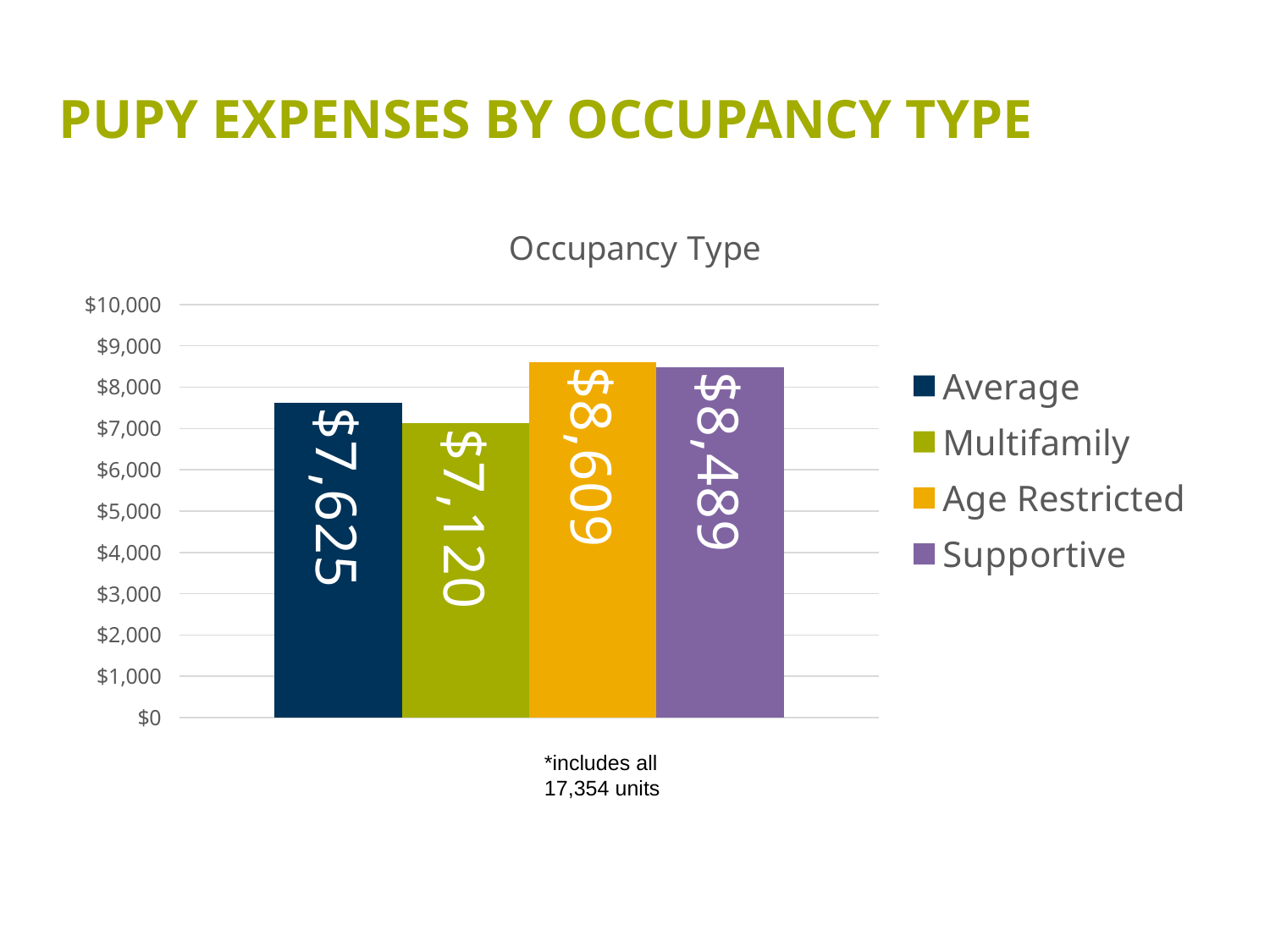
Which occupancy type has the highest PUPY expense? Age Restricted What is the difference between the Supportive value and the Average value? $864 What is the PUPY expense value for Multifamily? $7,120 What is the difference between the Age Restricted and Multifamily PUPY expense values? $1,489 Which occupancy type has the lowest PUPY expense? Multifamily Which is larger, the Multifamily value or the Average value? Average How many series does the legend list? 4 What is the PUPY expense value for Age Restricted? $8,609 What is the Average PUPY expense value shown on the chart? $7,625 What is the PUPY expense value for Supportive? $8,489 What kind of chart is shown on the slide? Bar chart What is the title of the chart? Occupancy Type